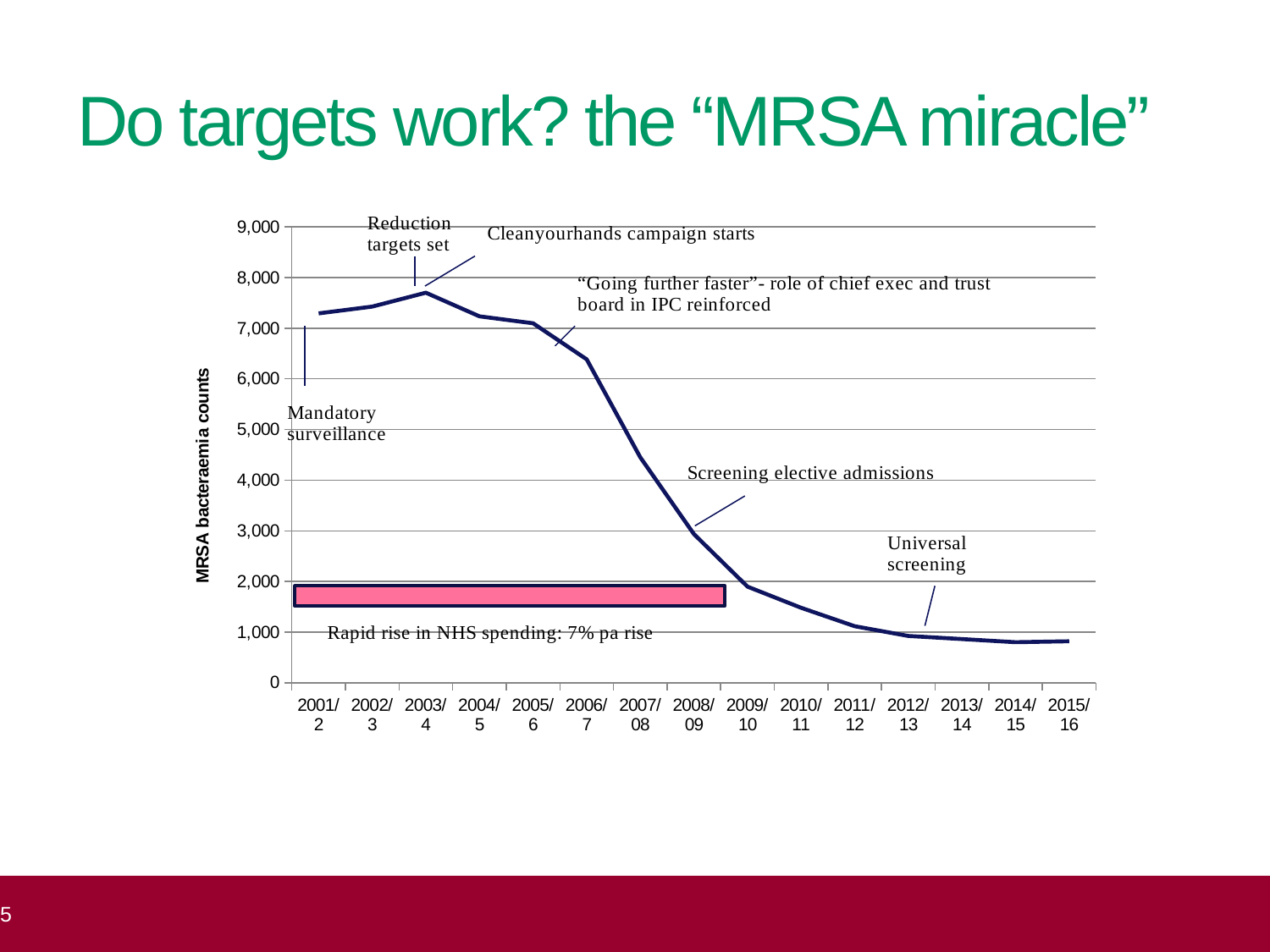
Is the value for 2003/4 greater or less than 7,000? greater How many years (data points) are plotted along the x axis? 15 What is the label on the y axis of the chart? MRSA bacteraemia counts Overall, do the MRSA bacteraemia counts rise or fall from 2001/2 to 2015/16? fall What does the pink bar annotation on the chart say? Rapid rise in NHS spending: 7% pa rise Is the value for 2009/10 greater or less than 2,000? less Is the value for 2006/7 greater or less than 6,000? greater What kind of chart is shown on the slide? line chart Which year has the larger MRSA bacteraemia count, 2006/7 or 2008/09? 2006/7 In which year is the MRSA bacteraemia count highest? 2003/4